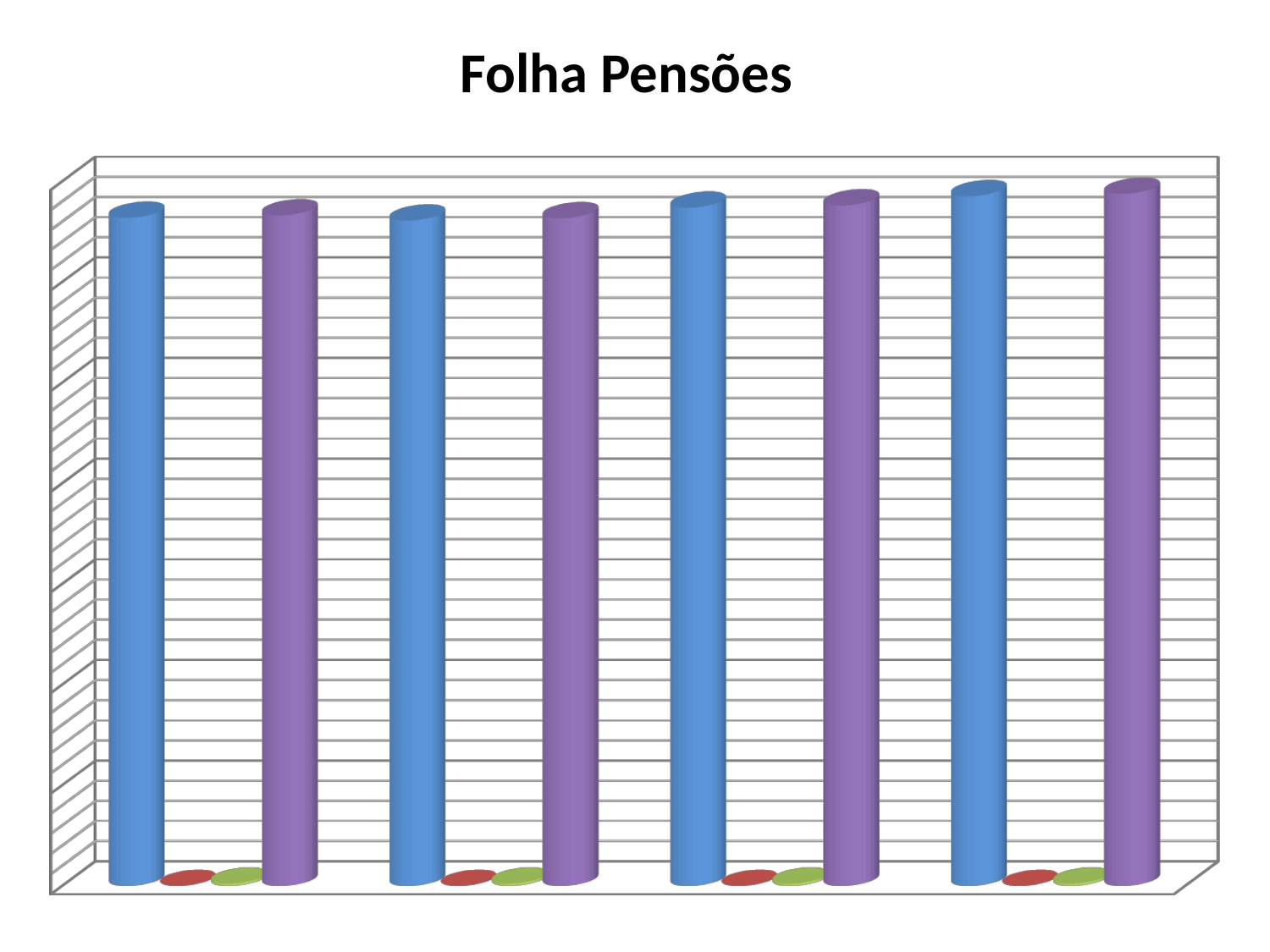
Do the purple bars generally rise or fall from the second category group to the fourth? rise How many differently coloured bar series appear in each category group? 4 Which category group, counting from the left, has the tallest purple bar? the fourth (rightmost) What kind of chart is shown on the slide? bar chart In the first category group from the left, which is larger: the blue bar or the red bar? the blue bar Which category group, counting from the left, has the tallest blue bar? the fourth (rightmost) How many groups of bars (categories) are plotted along the x axis? 4 In the rightmost category group, which is larger: the purple bar or the green bar? the purple bar Do the blue bars generally rise or fall from the second category group to the fourth? rise What is the title of the chart? Folha Pensões Which two bar colours are close to zero in every category group? red and green